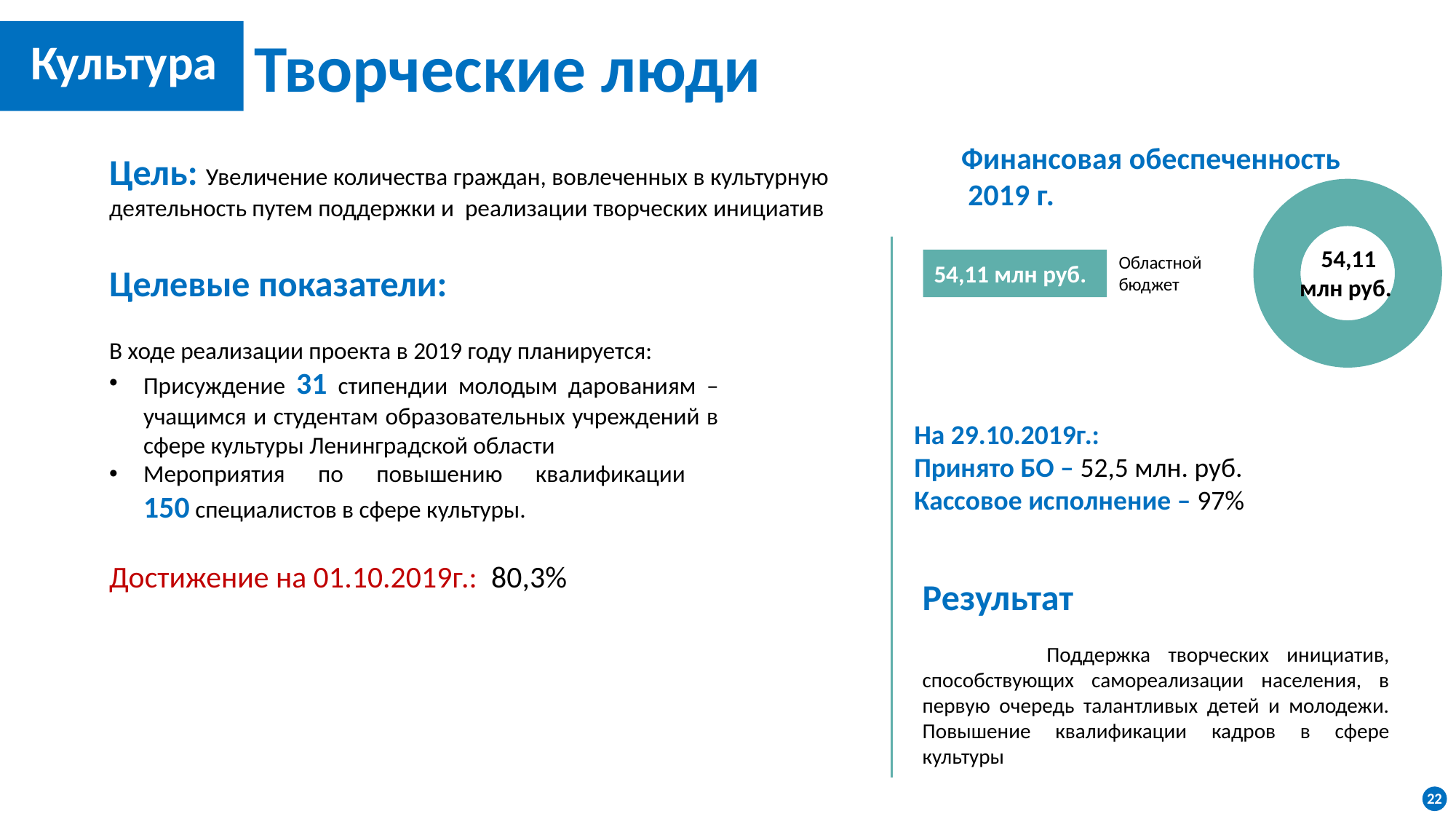
What is the title above the doughnut chart? Финансовая обеспеченность 2019 г. How many entries does the legend of the doughnut chart list? 1 What share of the doughnut chart does the "Областной бюджет" segment occupy? 100% What value is printed in the centre of the doughnut chart? 54,11 млн руб. How many segments does the doughnut chart contain? 1 What kind of chart is shown under the heading "Финансовая обеспеченность 2019 г."? doughnut (pie) chart What is the value of the "Областной бюджет" segment in the doughnut chart? 54,11 млн руб. Which budget source is named in the legend of the doughnut chart? Областной бюджет